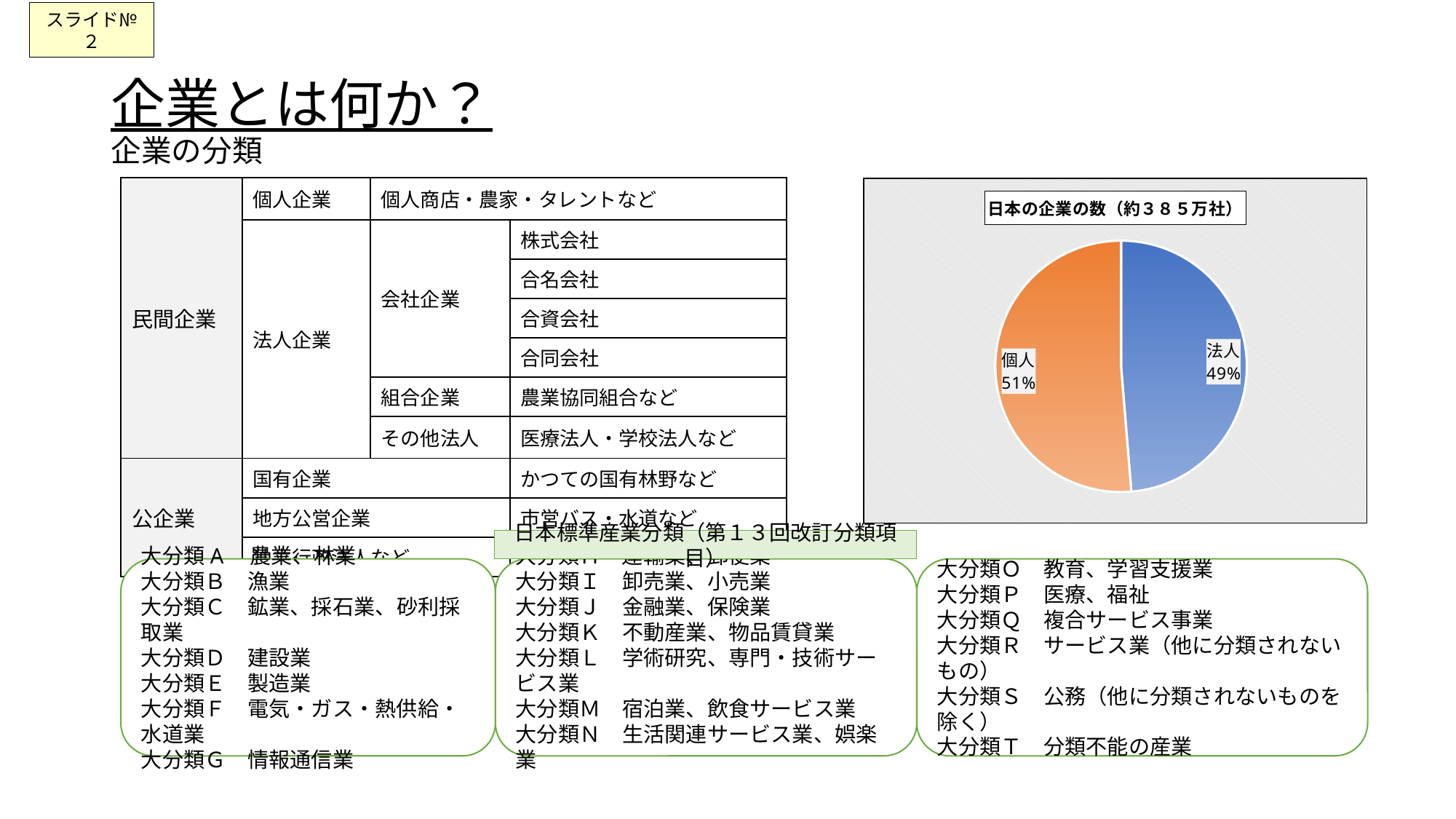
What is the difference in percentage points between the 個人 slice and the 法人 slice? 2 What colour is the 法人 slice of the pie chart? blue What share of the pie does the 個人 slice represent? 51% Which category has the largest share in the pie chart? 個人 What is the title of the pie chart? 日本の企業の数（約３８５万社） Which slice of the pie chart is larger, 法人 or 個人? 個人 What percentage of the pie chart is labelled 法人? 49% How many slices does the pie chart have? 2 What percentage of the pie chart is labelled 個人? 51% Which category has the smallest share in the pie chart? 法人 What kind of chart is shown on the slide? pie chart